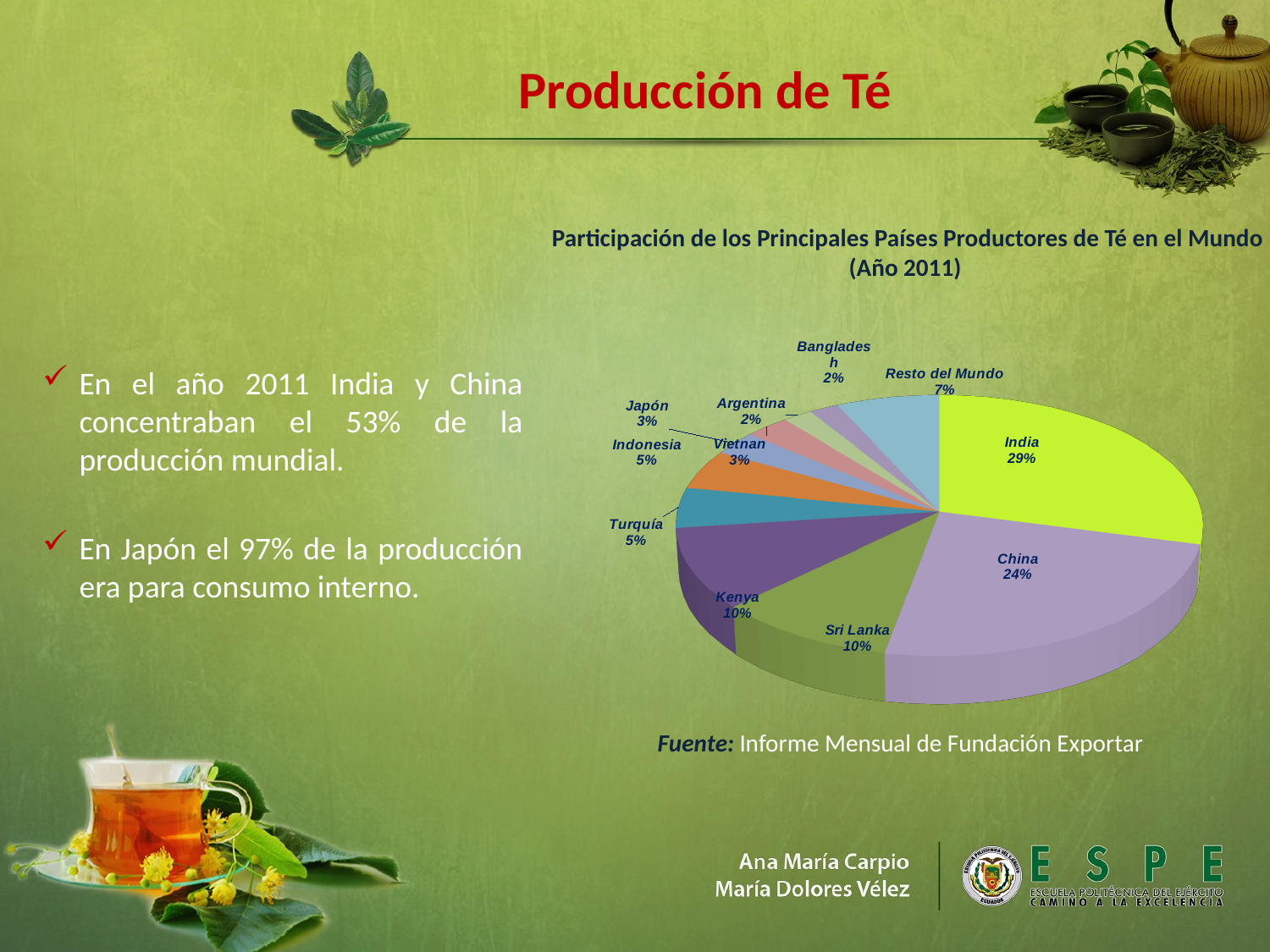
What type of chart is shown on the slide? pie chart What is the difference between India's share and China's share? 5% What share does China have in the pie chart? 24% What is the combined share of Japón and Vietnam? 6% What share does Resto del Mundo have in the pie chart? 7% What is the title of the chart? Participación de los Principales Países Productores de Té en el Mundo (Año 2011) How many slices does the pie chart have? 11 What share of world tea production does India have in the pie chart? 29% Which country has the largest slice in the pie chart? India Which has a larger share, Sri Lanka or Indonesia? Sri Lanka What share does Turquía have in the pie chart? 5% What share does Kenya have in the pie chart? 10%